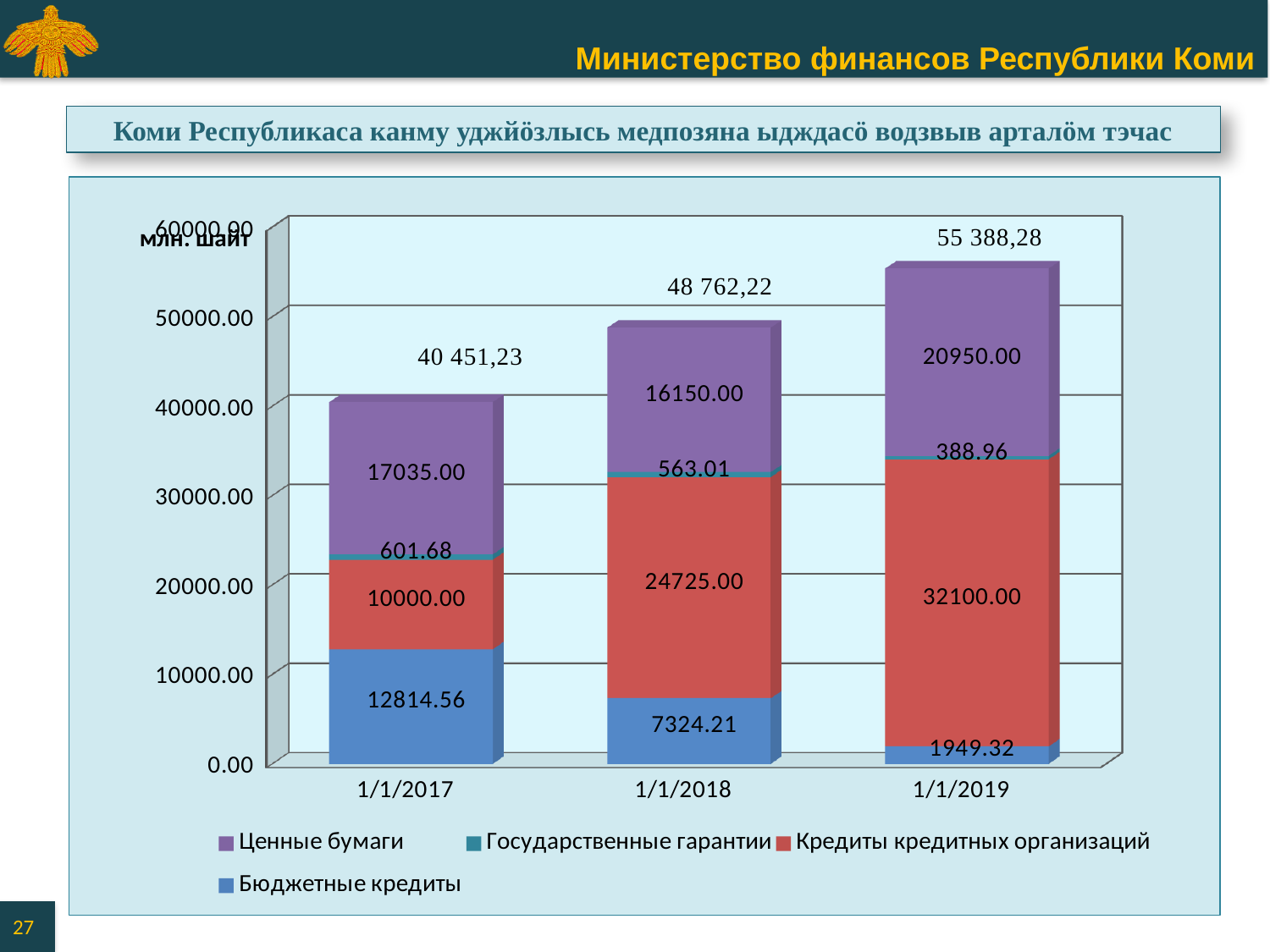
Which date has the highest total stacked bar? 1/1/2019 Which is larger: Ценные бумаги for 1/1/2017 or Ценные бумаги for 1/1/2018? 1/1/2017 What is the value of Бюджетные кредиты for 1/1/2017? 12814.56 What is the value of Государственные гарантии for 1/1/2018? 563.01 Which date has the lowest value for Бюджетные кредиты? 1/1/2019 What is the value of Кредиты кредитных организаций for 1/1/2019? 32100.00 How many series does the legend list? 4 How many dates are shown on the x axis? 3 What is the difference between Кредиты кредитных организаций for 1/1/2019 and 1/1/2018? 7375.00 What is the total of the stacked bar for 1/1/2018? 48 762,22 What is the value of Ценные бумаги for 1/1/2019? 20950.00 What kind of chart is shown on the slide? Stacked bar chart